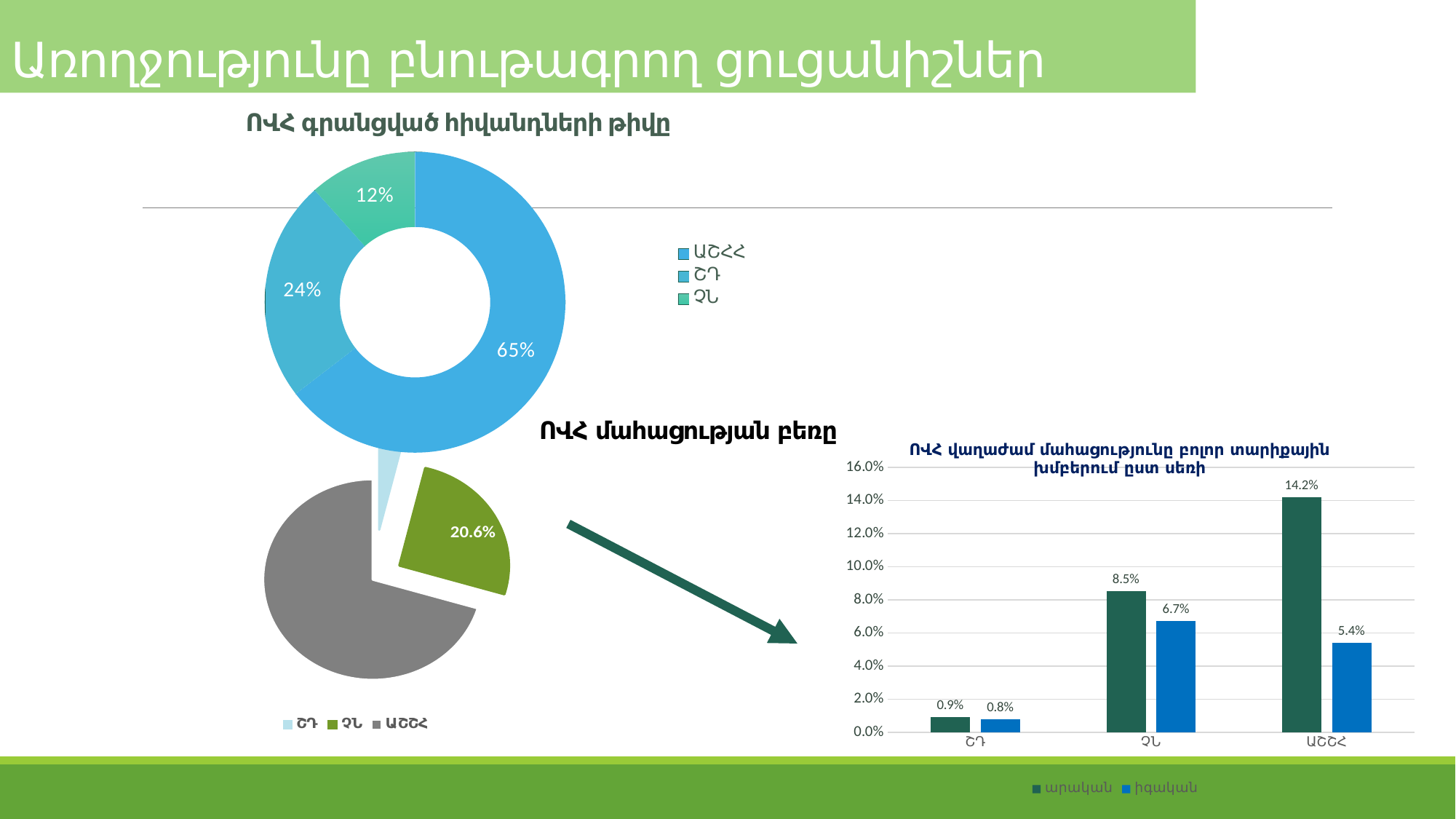
In the bar chart at the bottom right, what is the difference between the արական and իգական values for ԱՇՀՀ? 8.8% In the bar chart at the bottom right, which category has the lowest արական value? ՇԴ In the donut chart titled "ՈՎՀ գրանցված հիվանդների թիվը", what share does ՇԴ have? 24% In the pie chart titled "ՈՎՀ մահացության բեռը", what share is labelled on the green ՉՆ slice? 20.6% In the bar chart at the bottom right, how many series does the legend list? 2 In the donut chart titled "ՈՎՀ գրանցված հիվանդների թիվը", which category has the smallest share? ՉՆ In the pie chart titled "ՈՎՀ մահացության բեռը", which category has the largest slice? ԱՇՇՀ What kind of chart is shown at the bottom right of the slide? Bar chart In the bar chart at the bottom right, what is the value for իգական in the ՉՆ category? 6.7% In the donut chart titled "ՈՎՀ գրանցված հիվանդների թիվը", what share does ԱՇՀՀ have? 65% In the donut chart titled "ՈՎՀ գրանցված հիվանդների թիվը", how many categories does the legend list? 3 In the bar chart at the bottom right, what is the value for արական in the ԱՇՀՀ category? 14.2%